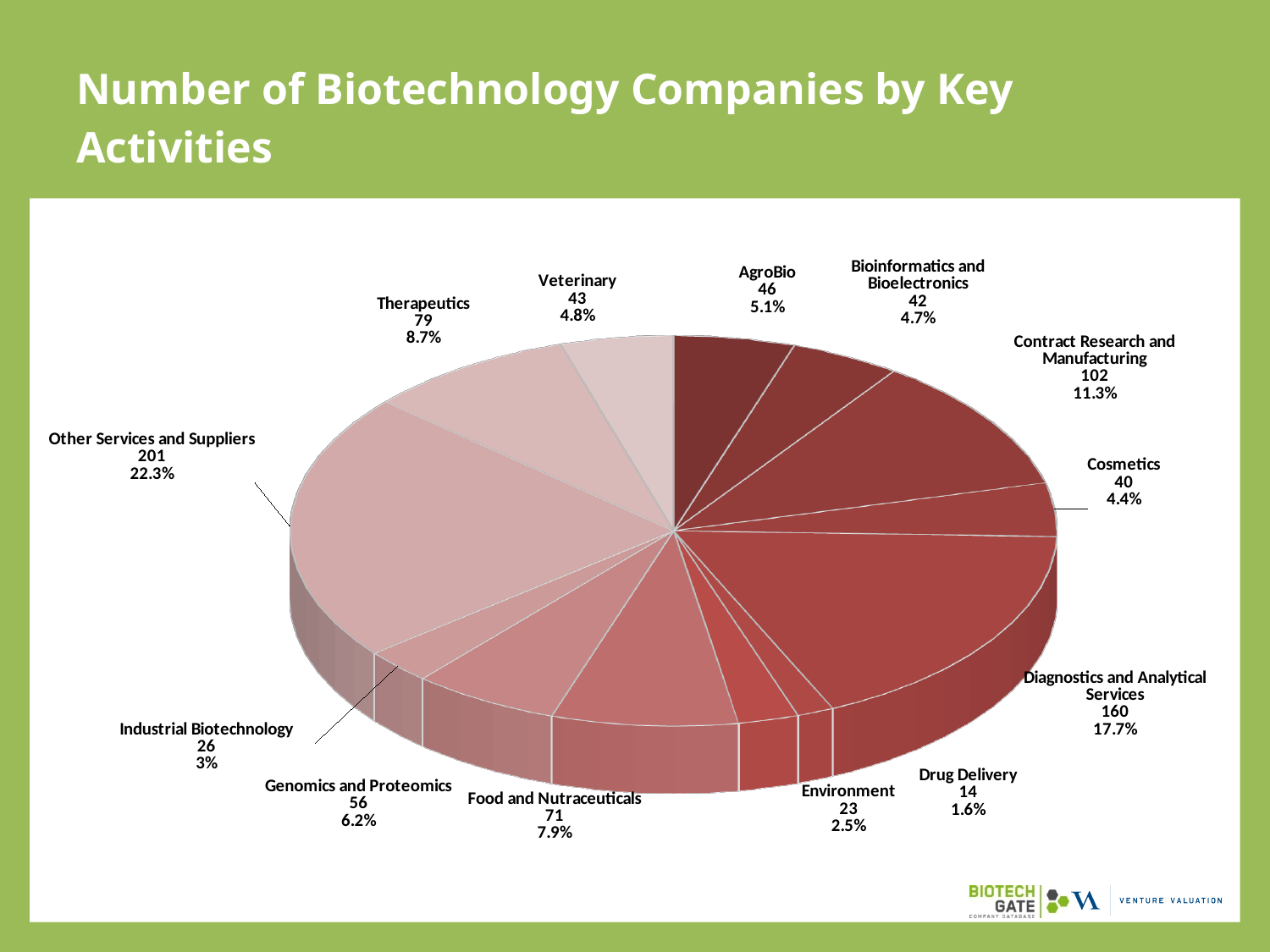
Which category has the largest number of companies? Other Services and Suppliers How many companies are in the Environment category? 23 What is the difference in the number of companies between Other Services and Suppliers and Diagnostics and Analytical Services? 41 Which has more companies, Therapeutics or Food and Nutraceuticals? Therapeutics How many companies are in the Diagnostics and Analytical Services category? 160 What percentage share does Cosmetics have? 4.4% What kind of chart is shown on the slide? Pie chart What share of the pie does Other Services and Suppliers represent? 22.3% Which category has the smallest number of companies? Drug Delivery What is the title of the slide? Number of Biotechnology Companies by Key Activities How many categories are shown in the pie chart? 13 How many companies are in Contract Research and Manufacturing? 102